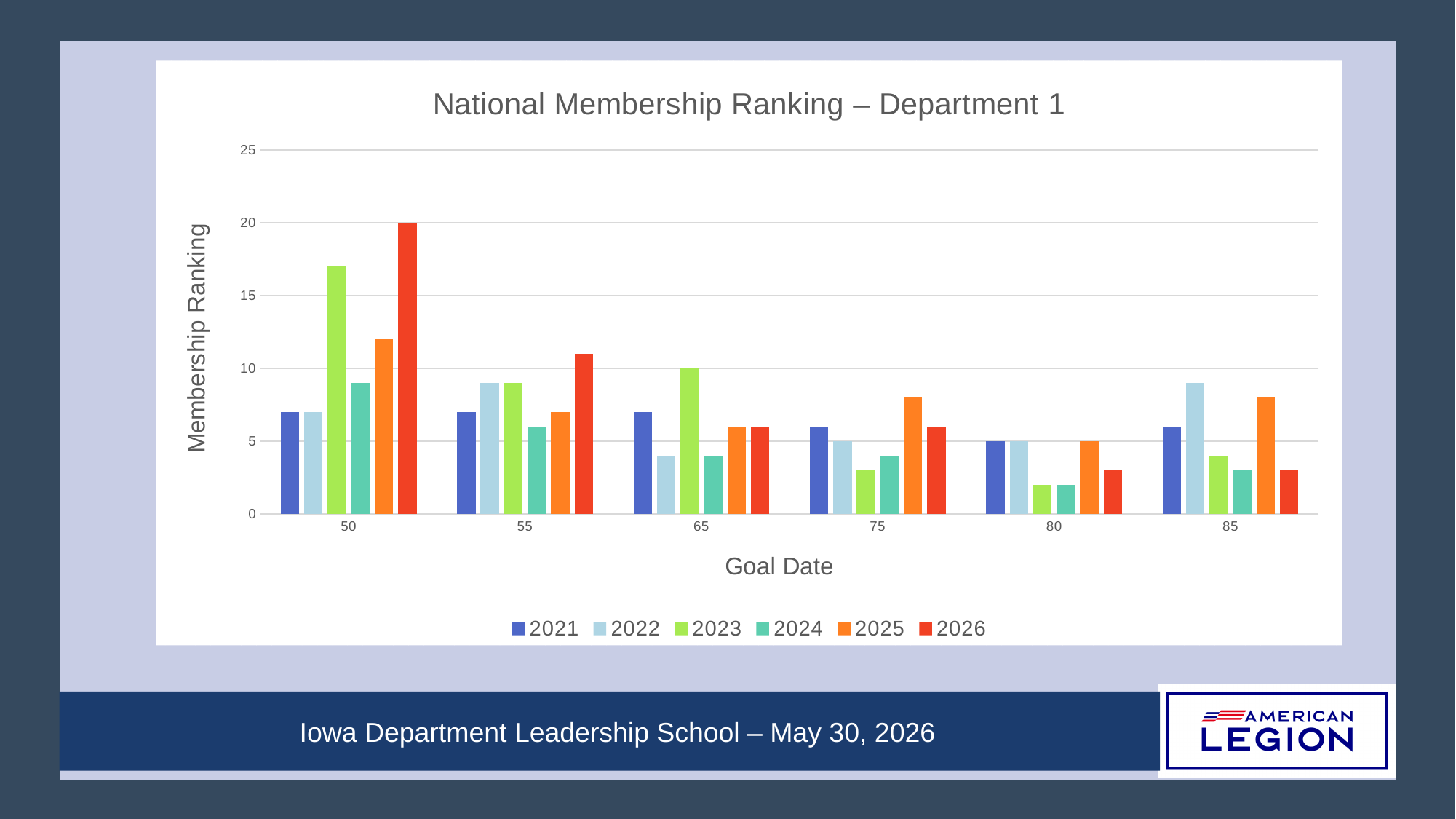
How many Goal Date categories are shown on the x axis? 6 Which series has the highest Membership Ranking at Goal Date 50? 2026 How many series does the legend list? 6 What is the title of the chart? National Membership Ranking – Department 1 At Goal Date 55, which is larger: the value for 2026 or the value for 2021? 2026 What is the Membership Ranking for 2023 at Goal Date 65? 10 What kind of chart is shown on the slide? bar chart What is the Membership Ranking for 2026 at Goal Date 50? 20 Which series has the highest Membership Ranking at Goal Date 65? 2023 Is the value for 2025 at Goal Date 50 greater or less than 10? greater What is the Membership Ranking for 2025 at Goal Date 80? 5 Is the value for 2023 at Goal Date 50 greater or less than 15? greater